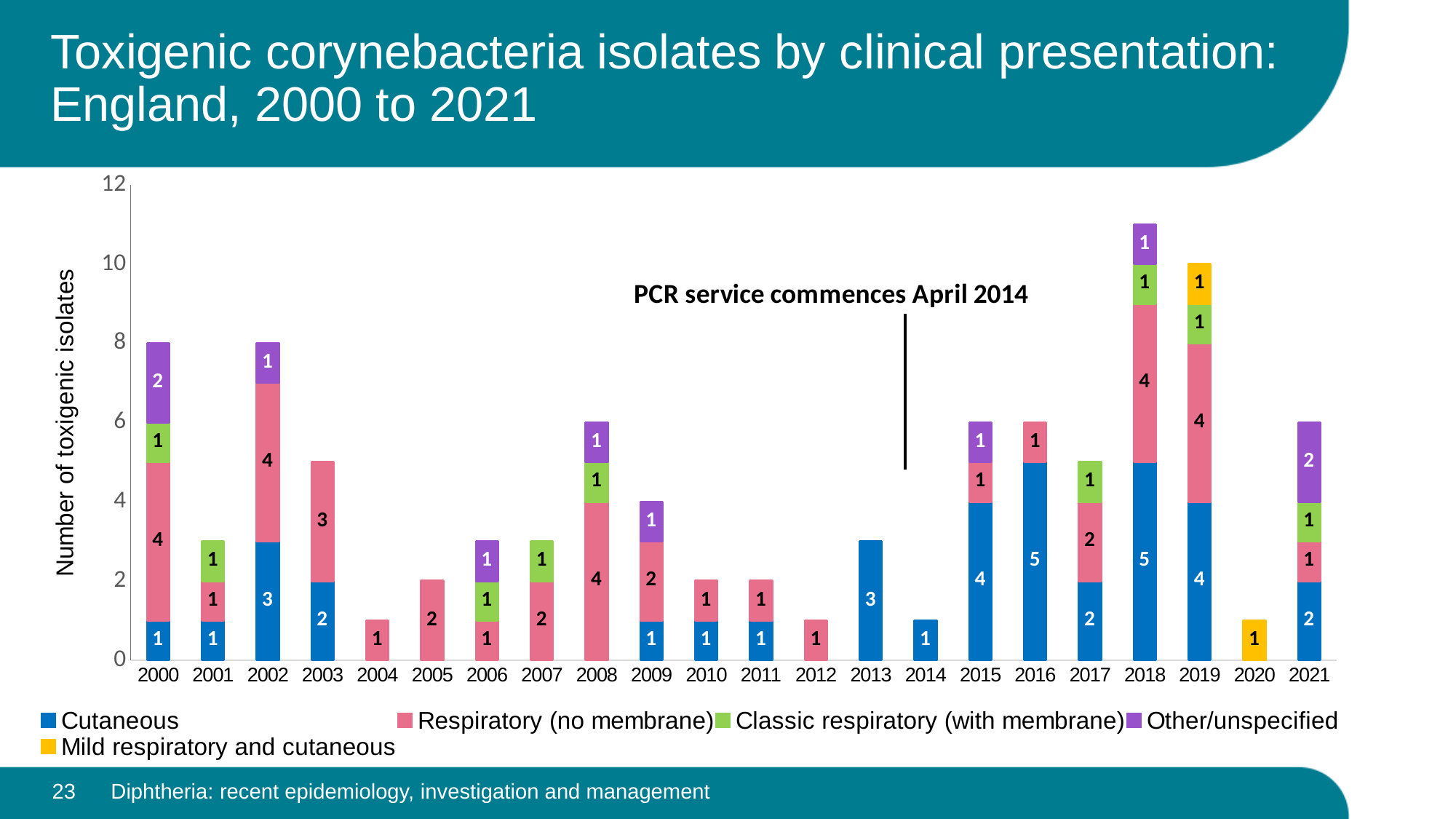
Which year has more Cutaneous isolates, 2015 or 2002? 2015 What is the total number of toxigenic isolates in 2019? 10 How many series does the legend list? 5 How many years are shown on the x axis? 22 What is the total number of toxigenic isolates in 2000? 8 Which year has the highest total number of toxigenic isolates? 2018 What is the number of Other/unspecified isolates in 2021? 2 According to the annotation on the chart, when did the PCR service commence? April 2014 What is the number of Cutaneous isolates in 2016? 5 What is the difference between the Cutaneous isolates in 2018 and in 2017? 3 What is the number of Respiratory (no membrane) isolates in 2018? 4 What type of chart is shown on the slide? Stacked bar chart